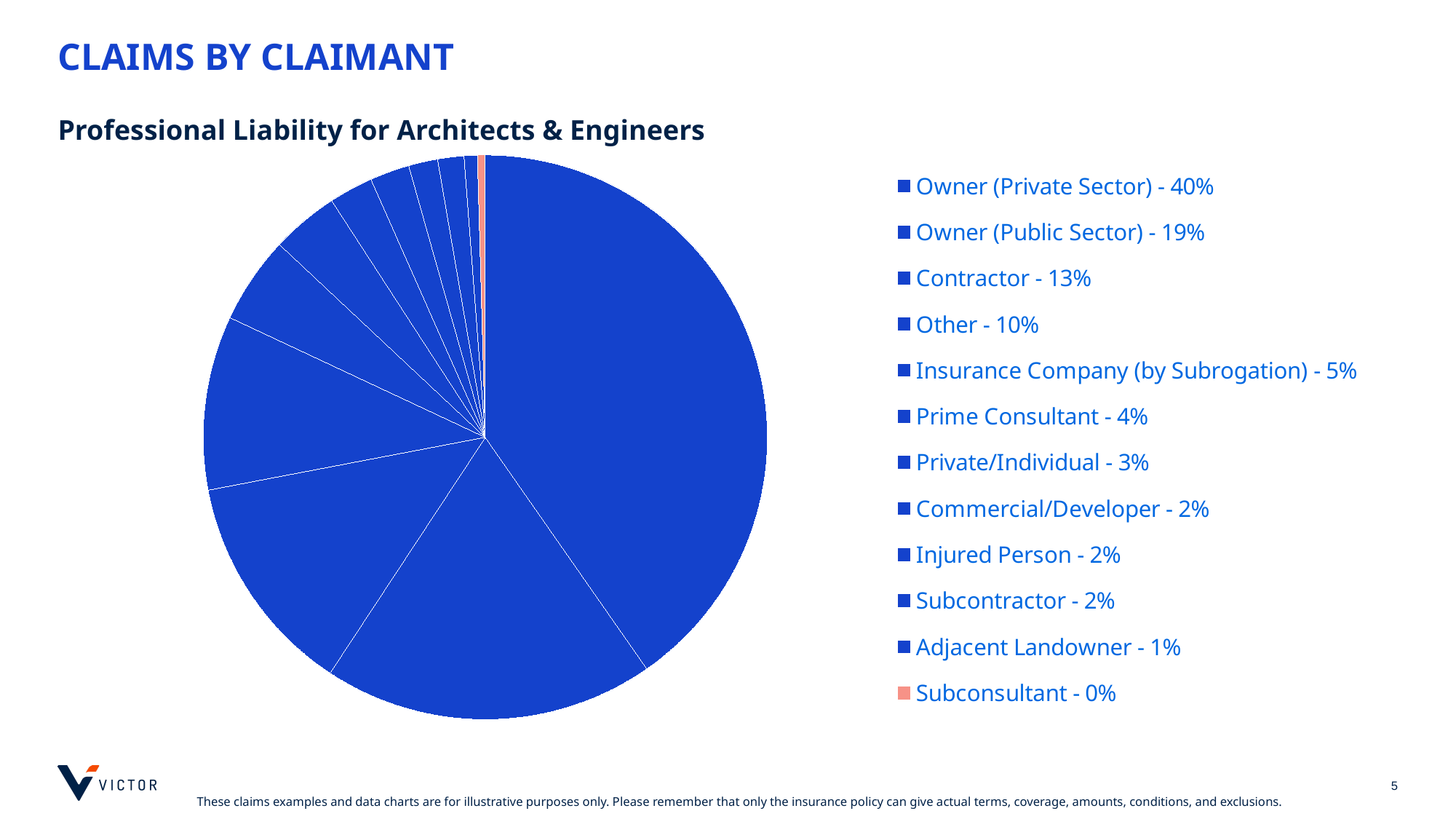
Which claimant category has the smallest share of claims? Subconsultant What share of claims is attributed to Owner (Private Sector)? 40% Which has a larger share of claims, Contractor or Other? Contractor What percentage is shown for Insurance Company (by Subrogation)? 5% What is the difference in percentage points between Owner (Private Sector) and Owner (Public Sector)? 21 Which claimant category has the largest share of claims? Owner (Private Sector) How many claimant categories are listed in the legend? 12 What percentage is shown for Adjacent Landowner? 1% Which legend entry is shown in a different colour (salmon/pink) from the rest? Subconsultant - 0% What kind of chart is shown on the slide? pie chart What is the combined share of Owner (Private Sector) and Owner (Public Sector)? 59% What share of claims is attributed to Contractor? 13%